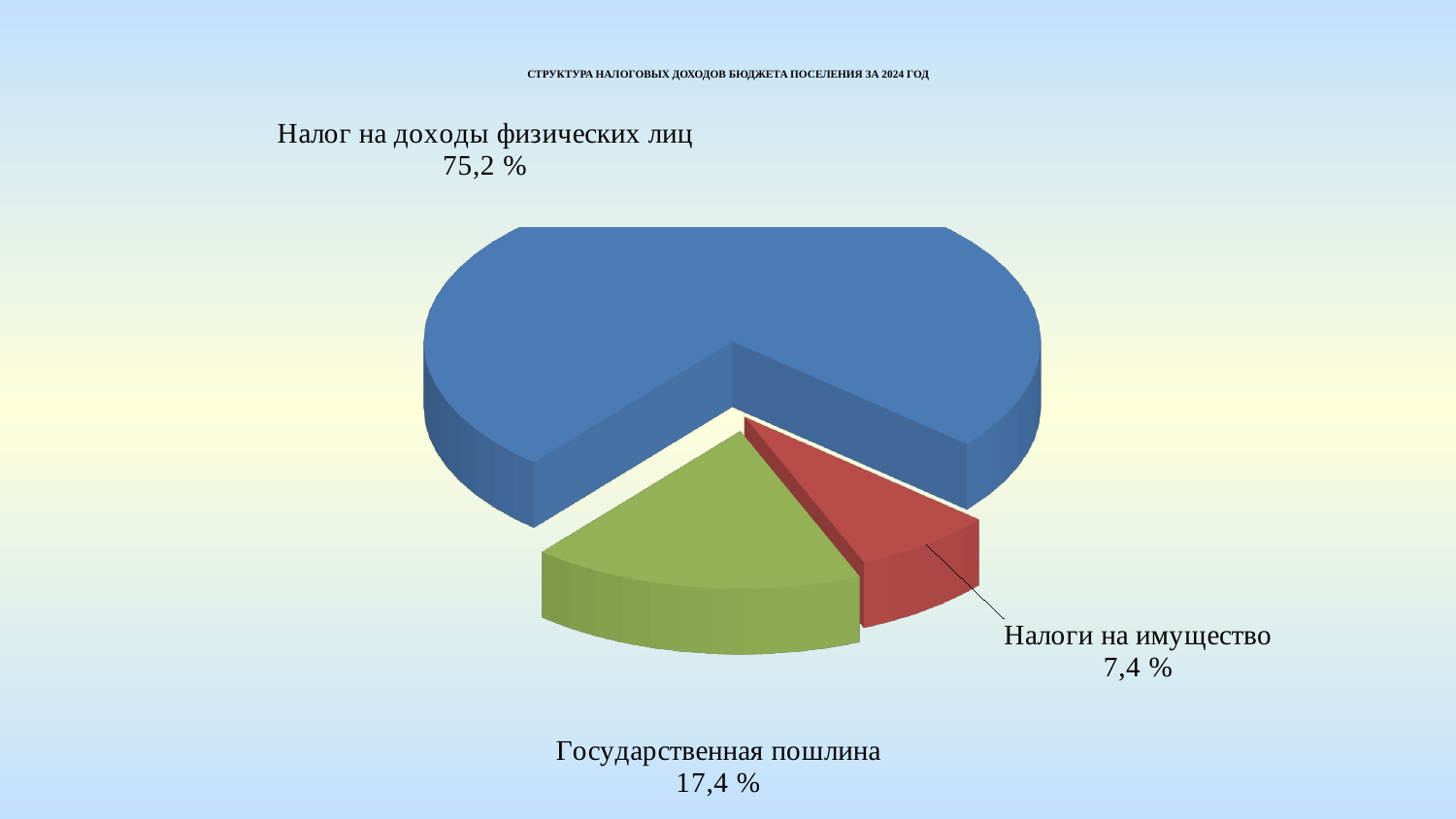
What is the title of the chart? СТРУКТУРА НАЛОГОВЫХ ДОХОДОВ БЮДЖЕТА ПОСЕЛЕНИЯ ЗА 2024 ГОД What kind of chart is shown on the slide? Pie chart What is the difference between the shares of Государственная пошлина and Налоги на имущество? 10,0 % How many slices does the pie chart have? 3 What value is shown for Государственная пошлина? 17,4 % Which category has the smallest slice of the pie? Налоги на имущество What is the difference between the shares of Налог на доходы физических лиц and Государственная пошлина? 57,8 % What colour is the slice for Налоги на имущество? Red Which category has the largest slice of the pie? Налог на доходы физических лиц What value is shown for Налоги на имущество? 7,4 % Which is larger, the share of Государственная пошлина or the share of Налоги на имущество? Государственная пошлина What share of the pie does Налог на доходы физических лиц have? 75,2 %